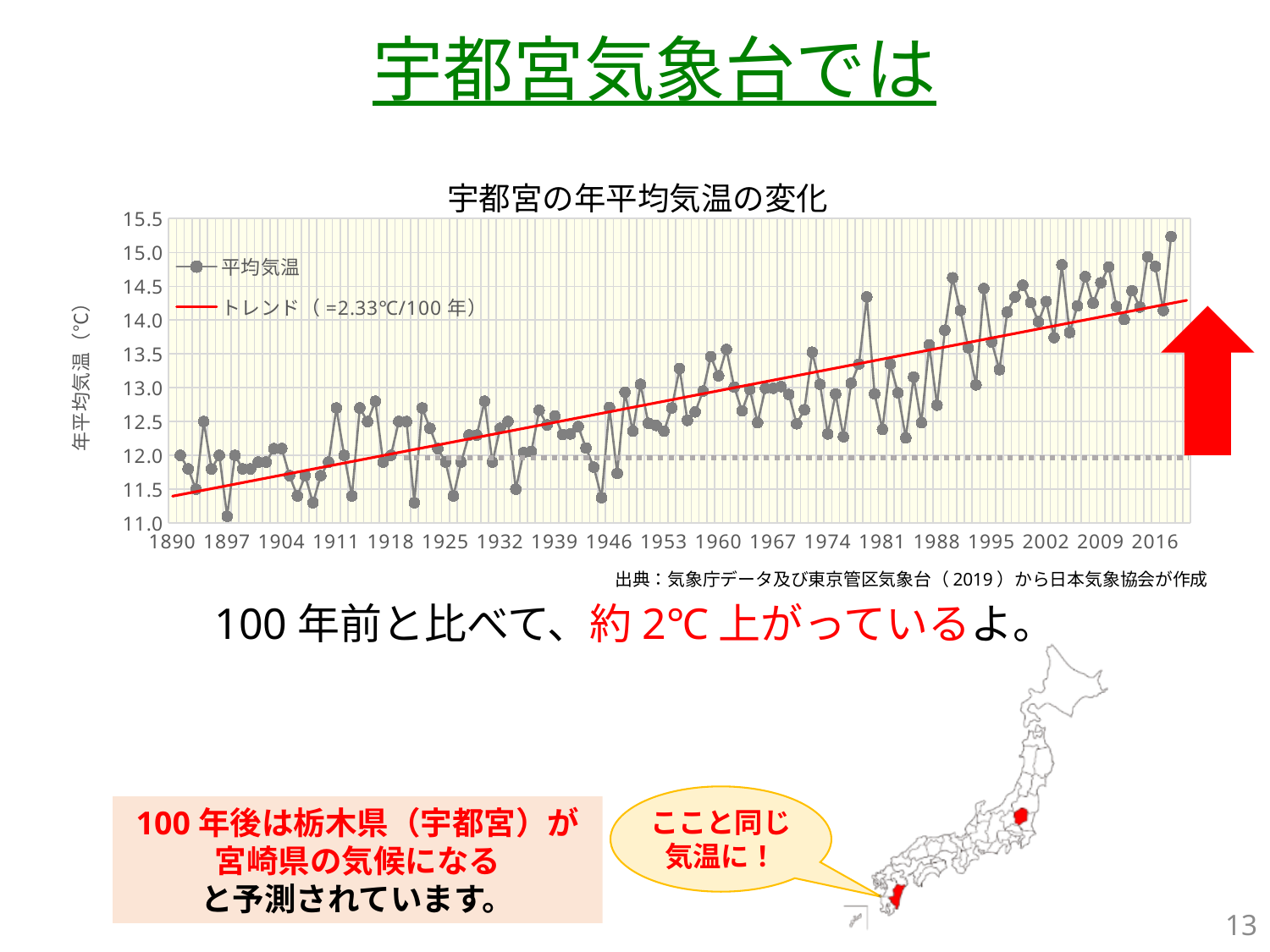
Do the plotted annual mean temperatures generally rise or fall from 1890 to 2016? rise What is the title of the chart? 宇都宮の年平均気温の変化 How many series does the chart legend list? 2 What is the highest value shown on the y axis? 15.5 What kind of chart is shown on the slide? line chart What rate of change is given for the トレンド line in the legend? 2.33℃/100年 Is the 平均気温 value for 1897 greater or less than 11.5? less Which year shown on the x axis has the lowest 平均気温 value? 1897